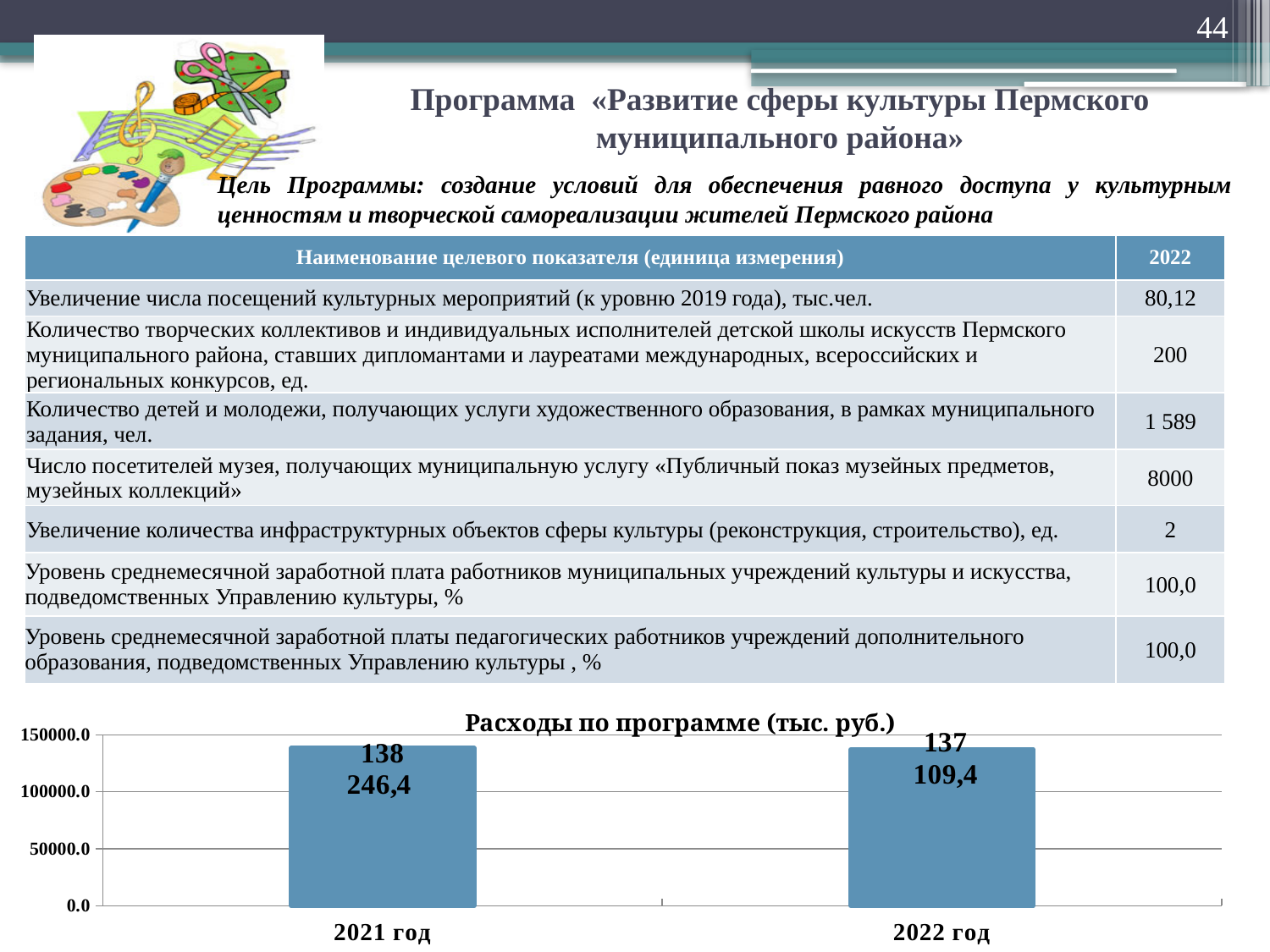
In the chart «Расходы по программе (тыс. руб.)», what is the difference between the values for 2021 год and 2022 год? 1 137,0 What type of chart is shown under the title «Расходы по программе (тыс. руб.)»? bar chart What is the title of the chart at the bottom of the slide? Расходы по программе (тыс. руб.) How many categories are plotted in the chart «Расходы по программе (тыс. руб.)»? 2 In the chart «Расходы по программе (тыс. руб.)», what is the value for 2021 год? 138 246,4 What is the highest value shown on the vertical axis of the chart «Расходы по программе (тыс. руб.)»? 150000.0 In the chart «Расходы по программе (тыс. руб.)», do the values rise or fall from 2021 год to 2022 год? fall In the chart «Расходы по программе (тыс. руб.)», is the value for 2022 год greater or less than 100000.0? greater In the chart «Расходы по программе (тыс. руб.)», what is the value for 2022 год? 137 109,4 In the chart «Расходы по программе (тыс. руб.)», is the value for 2021 год larger or smaller than the value for 2022 год? larger In the chart «Расходы по программе (тыс. руб.)», which year has the lower value? 2022 год In the chart «Расходы по программе (тыс. руб.)», which year has the higher value? 2021 год